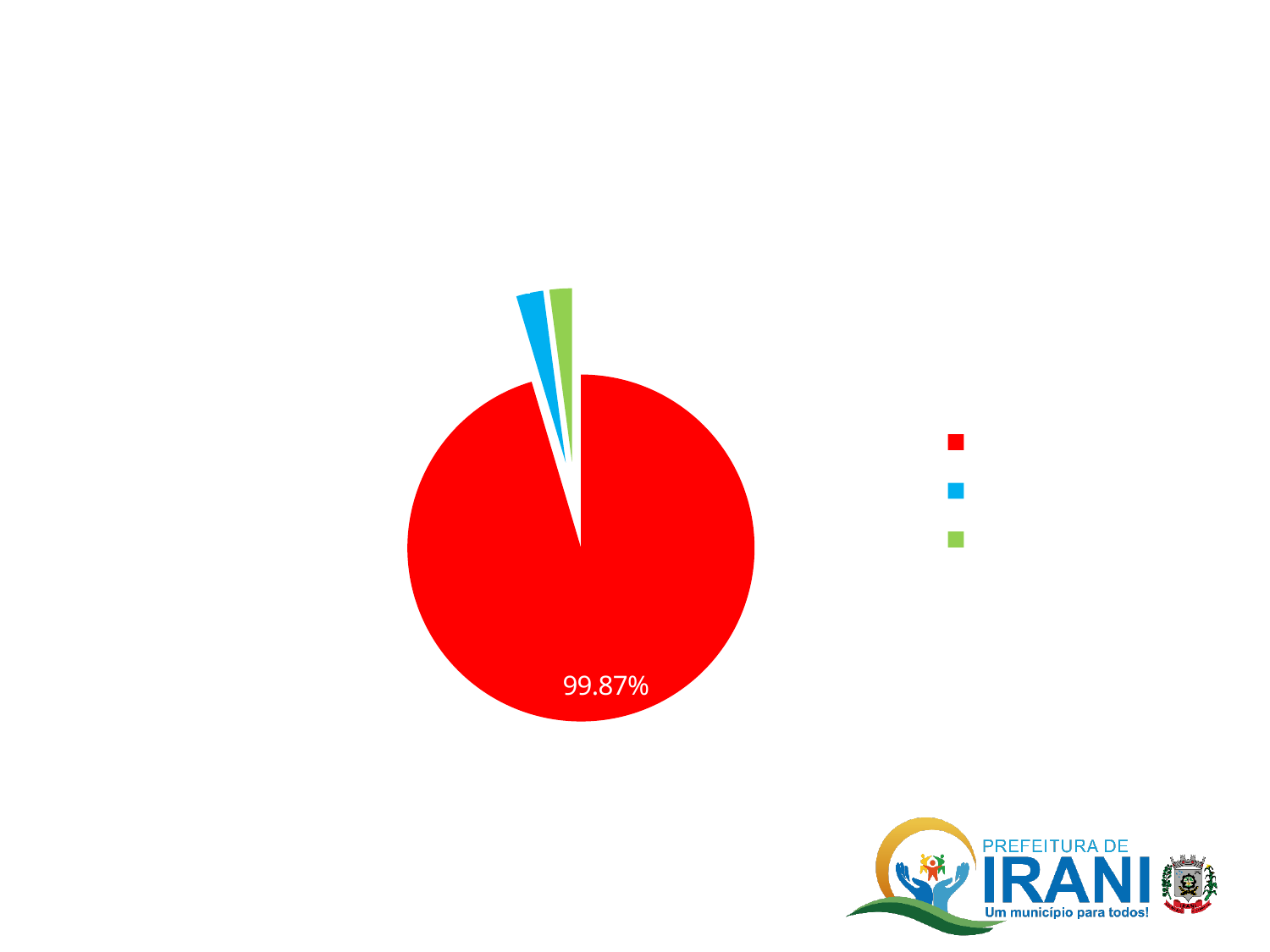
What colour is the slice that takes up almost the entire pie chart? red What percentage is printed on the red slice of the pie chart? 99.87% Is the red slice of the pie chart larger or smaller than the blue slice? larger How many entries does the legend of the pie chart list? 3 Which colours are used for the three legend entries of the pie chart? red, blue and green What kind of chart is shown on the slide? pie chart How many slices does the pie chart have? 3 Which slice of the pie chart is the largest? the red slice